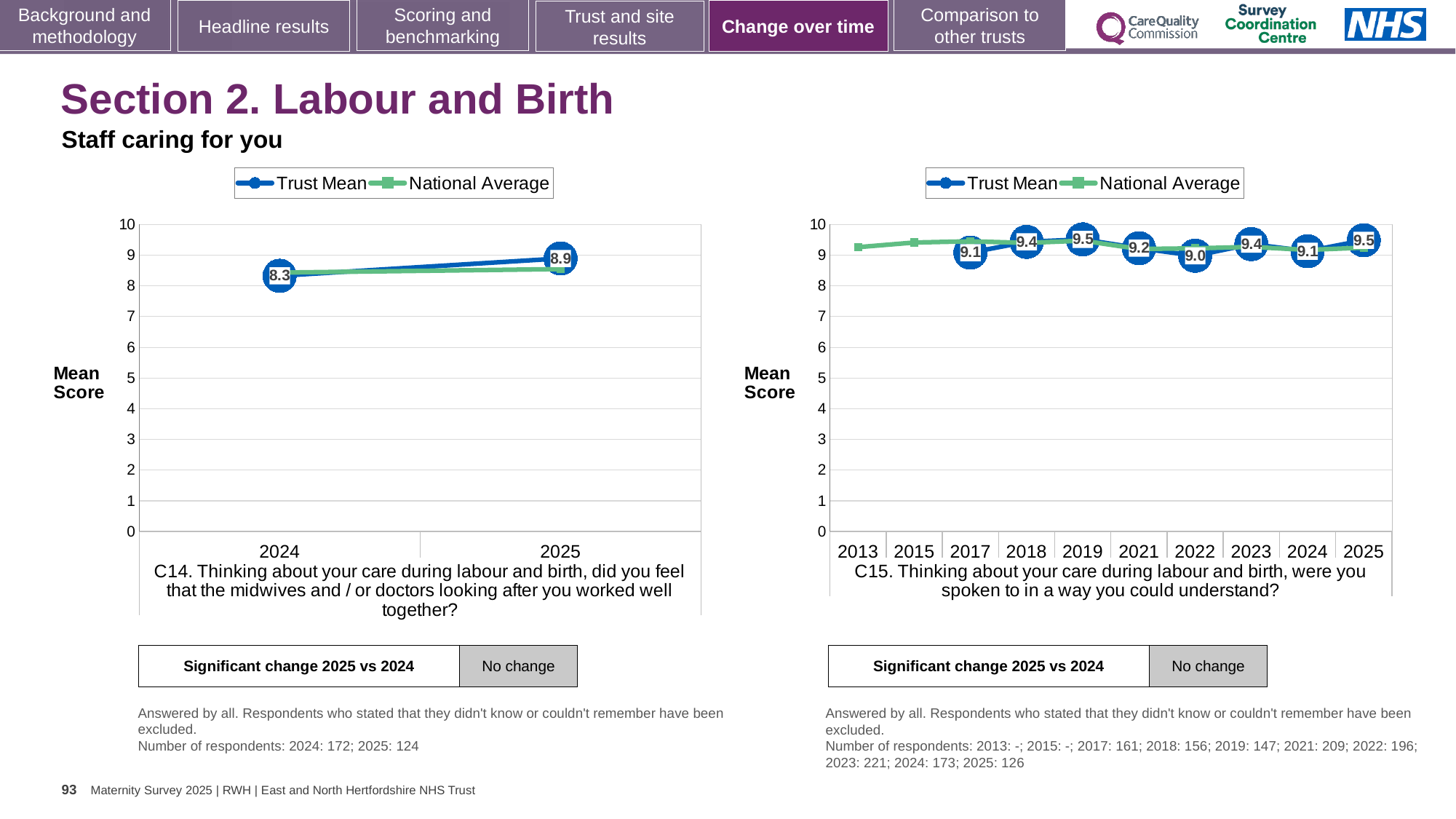
In the C14 chart on the left, what is the Trust Mean score for 2024? 8.3 In the C15 chart on the right, what is the Trust Mean score for 2022? 9.0 In the C14 chart on the left, what is the Trust Mean score for 2025? 8.9 In the C15 chart on the right, is the Trust Mean higher in 2023 or in 2024? 2023 What type of chart is the C15 chart on the right? line chart In the C14 chart on the left, does the Trust Mean rise or fall from 2024 to 2025? rise In the C15 chart on the right, what is the difference between the Trust Mean in 2019 and in 2022? 0.5 How many series does the legend of the C14 chart on the left list? 2 In the C15 chart on the right, which year has the lowest Trust Mean score? 2022 In the C14 chart on the left, by how much did the Trust Mean change from 2024 to 2025? 0.6 In the C15 chart on the right, how many years are shown on the x axis? 10 In the C15 chart on the right, what is the Trust Mean score for 2018? 9.4